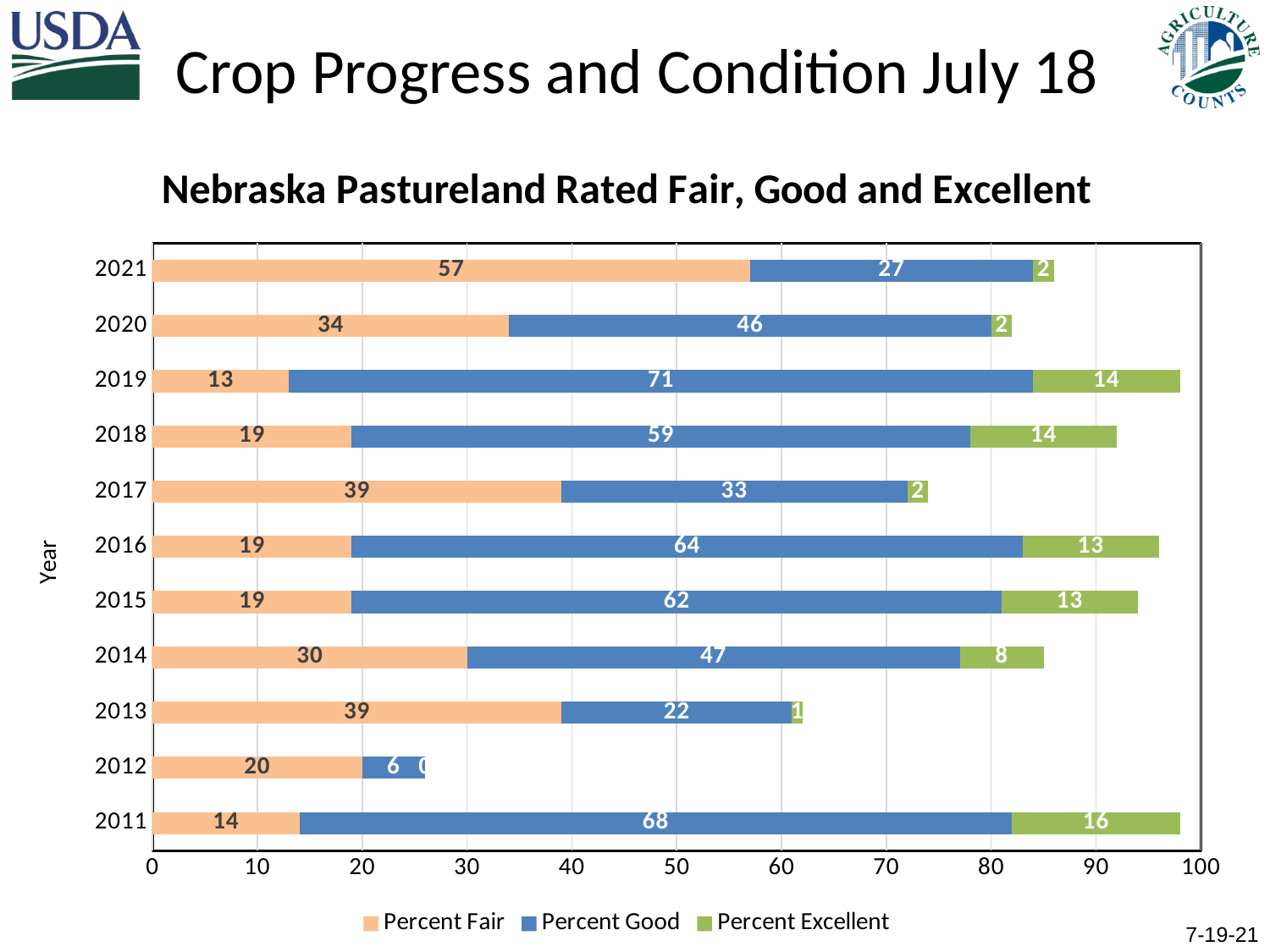
What kind of chart is shown on the slide? Stacked bar chart How many years are shown on the chart? 11 What is the Percent Good value for 2019? 71 Which year has the lowest Percent Good value? 2012 Which year has the highest Percent Good value? 2019 How many series does the legend list? 3 What is the difference between the Percent Fair values for 2021 and 2020? 23 What is the Percent Excellent value for 2011? 16 What is the total of the stacked bar for 2018? 92 What is the Percent Fair value for 2021? 57 What is the title of the chart? Nebraska Pastureland Rated Fair, Good and Excellent Which is larger, the Percent Good value for 2016 or for 2015? 2016